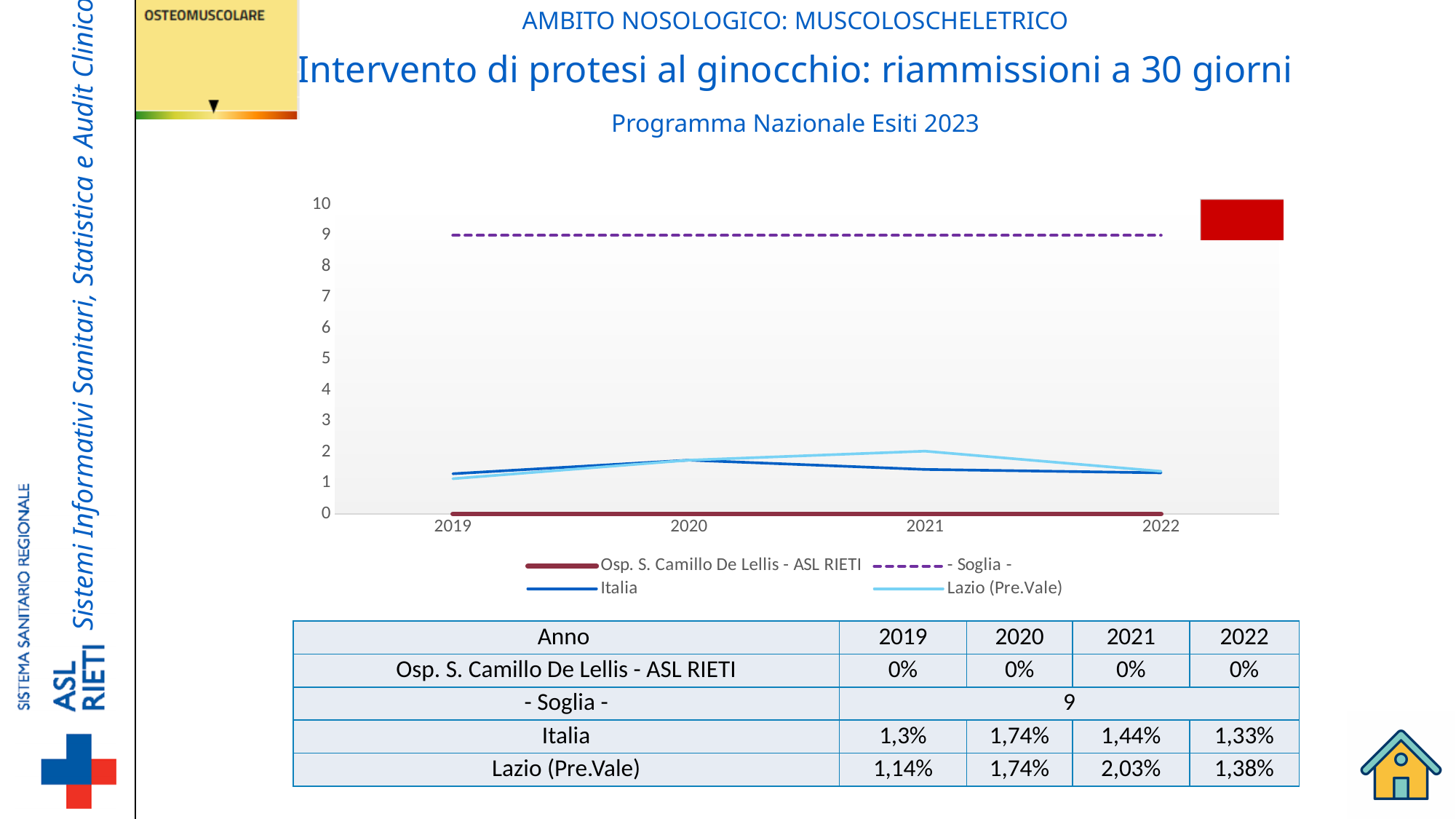
What is the value for Lazio (Pre.Vale) in 2021? 2,03% What is the difference between the Lazio (Pre.Vale) and Italia values in 2021? 0,59% In which year is the Italia value lowest? 2019 What is the value for Osp. S. Camillo De Lellis - ASL RIETI in 2022? 0% In which year is the Lazio (Pre.Vale) value highest? 2021 What is the value of the Soglia (threshold) line? 9 How many years are plotted along the x axis? 4 What kind of chart is shown on the slide? line chart Is the Soglia line greater or less than 5 on the y axis? greater How many series does the chart legend list? 4 What is the value for Italia in 2020? 1,74% Which is larger in 2019, the Italia value or the Lazio (Pre.Vale) value? Italia